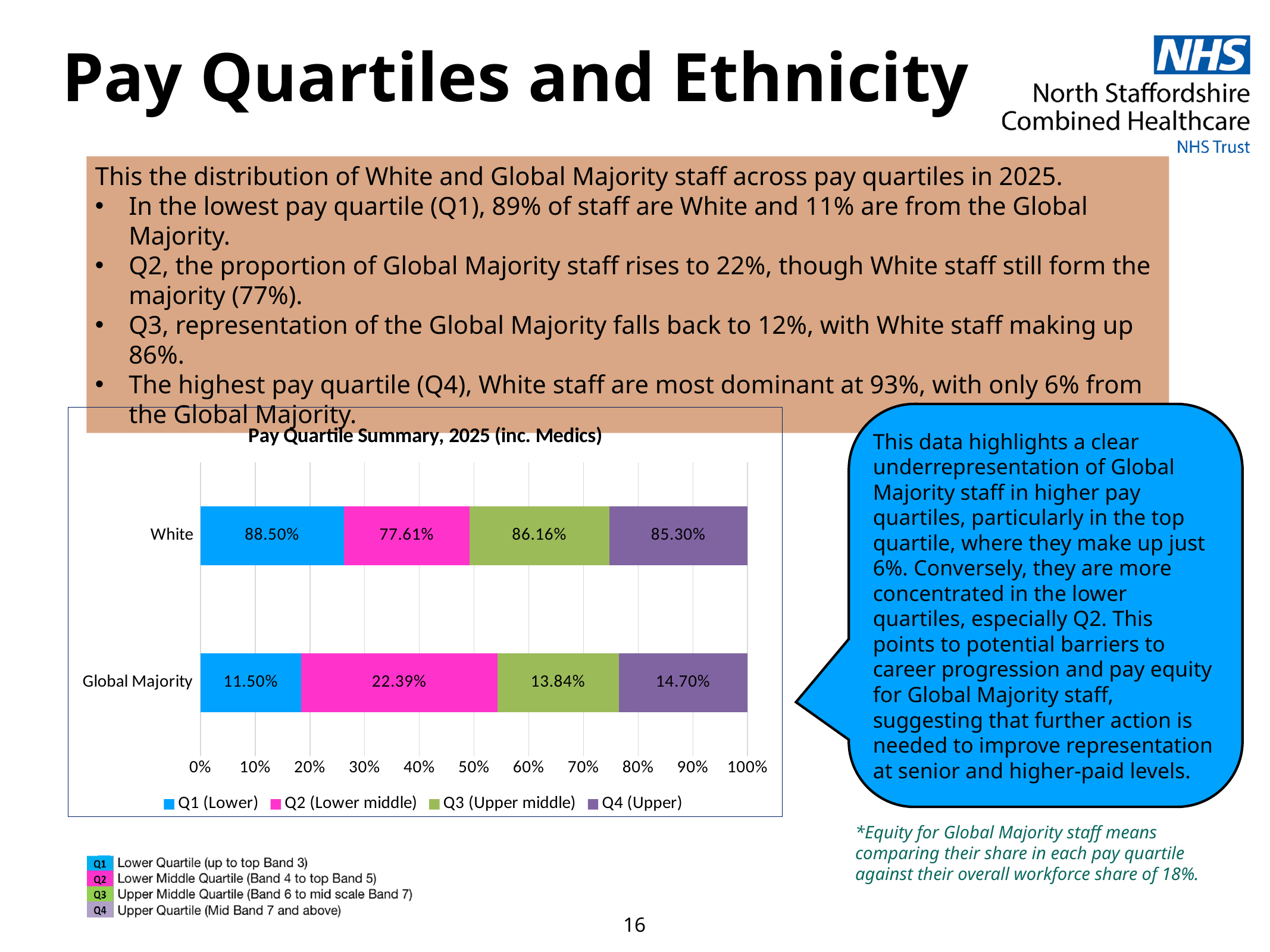
What kind of chart is the Pay Quartile Summary? Stacked bar chart How many series does the chart legend list? 4 Which quartile has the highest value for Global Majority? Q2 (Lower middle) What is the Q1 (Lower) value for White in the Pay Quartile Summary chart? 88.50% What is the title of the chart? Pay Quartile Summary, 2025 (inc. Medics) Which quartile has the lowest value for White? Q2 (Lower middle) What is the Q4 (Upper) value for White? 85.30% How many categories are shown on the vertical axis of the chart? 2 Which is larger for Global Majority: the Q3 (Upper middle) value or the Q4 (Upper) value? Q4 (Upper) What is the difference between the Q1 (Lower) values for White and Global Majority? 77.00% What is the Q2 (Lower middle) value for Global Majority? 22.39% What is the Q3 (Upper middle) value for Global Majority? 13.84%